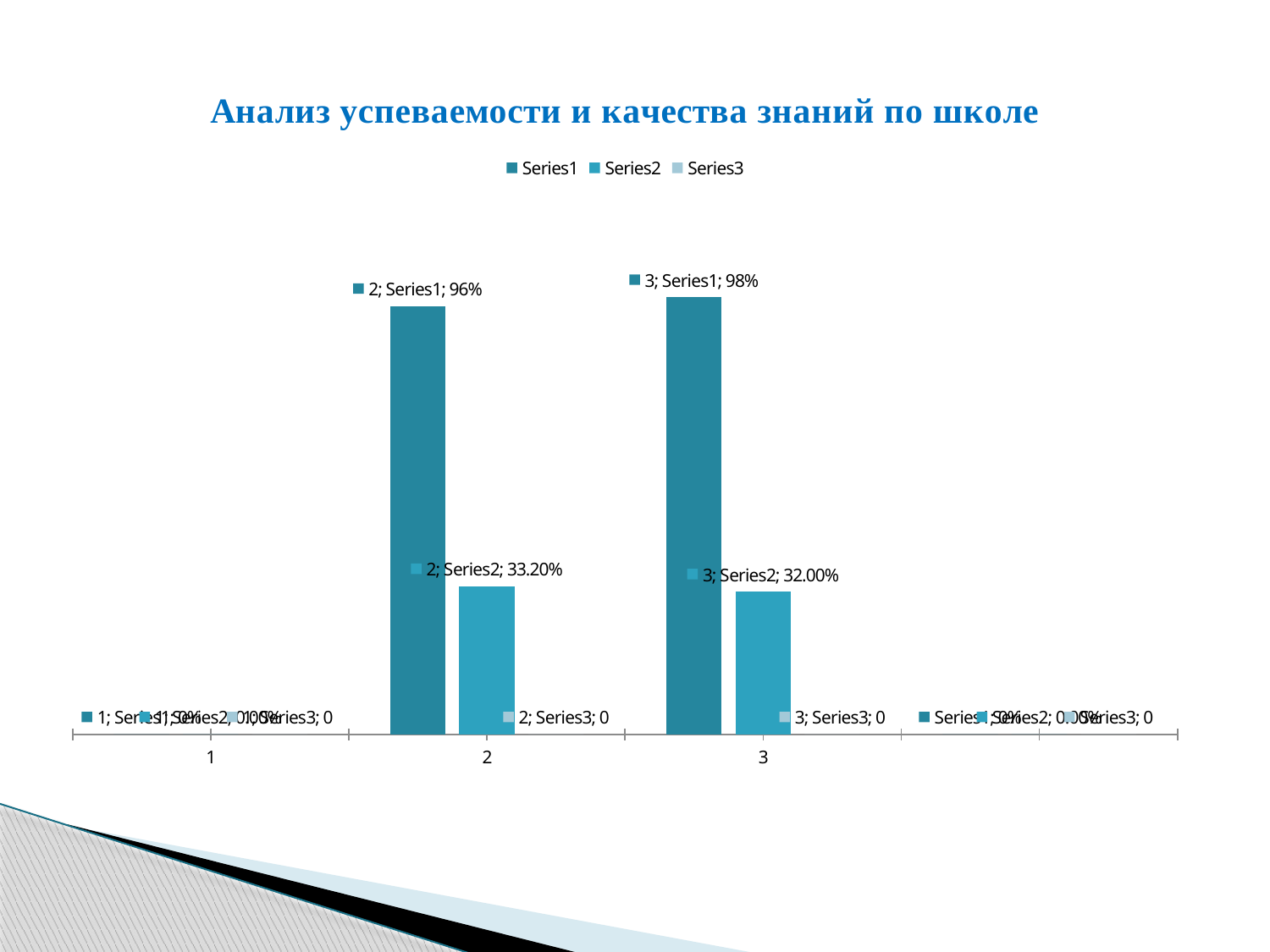
Which is larger, Series1 for category 2 or Series1 for category 3? Series1 for category 3 What is the value of Series1 for category 3? 98% What is the value of Series3 for category 2? 0 What kind of chart is shown on the slide? Bar chart How many series does the legend list? 3 What is the value of Series2 for category 2? 33.20% What is the difference between Series1 and Series2 for category 3? 66.00% What is the title of the chart? Анализ успеваемости и качества знаний по школе What is the difference between Series1 for category 3 and Series1 for category 2? 2% Which is larger, Series2 for category 2 or Series2 for category 3? Series2 for category 2 What is the value of Series2 for category 3? 32.00% What is the value of Series1 for category 2? 96%